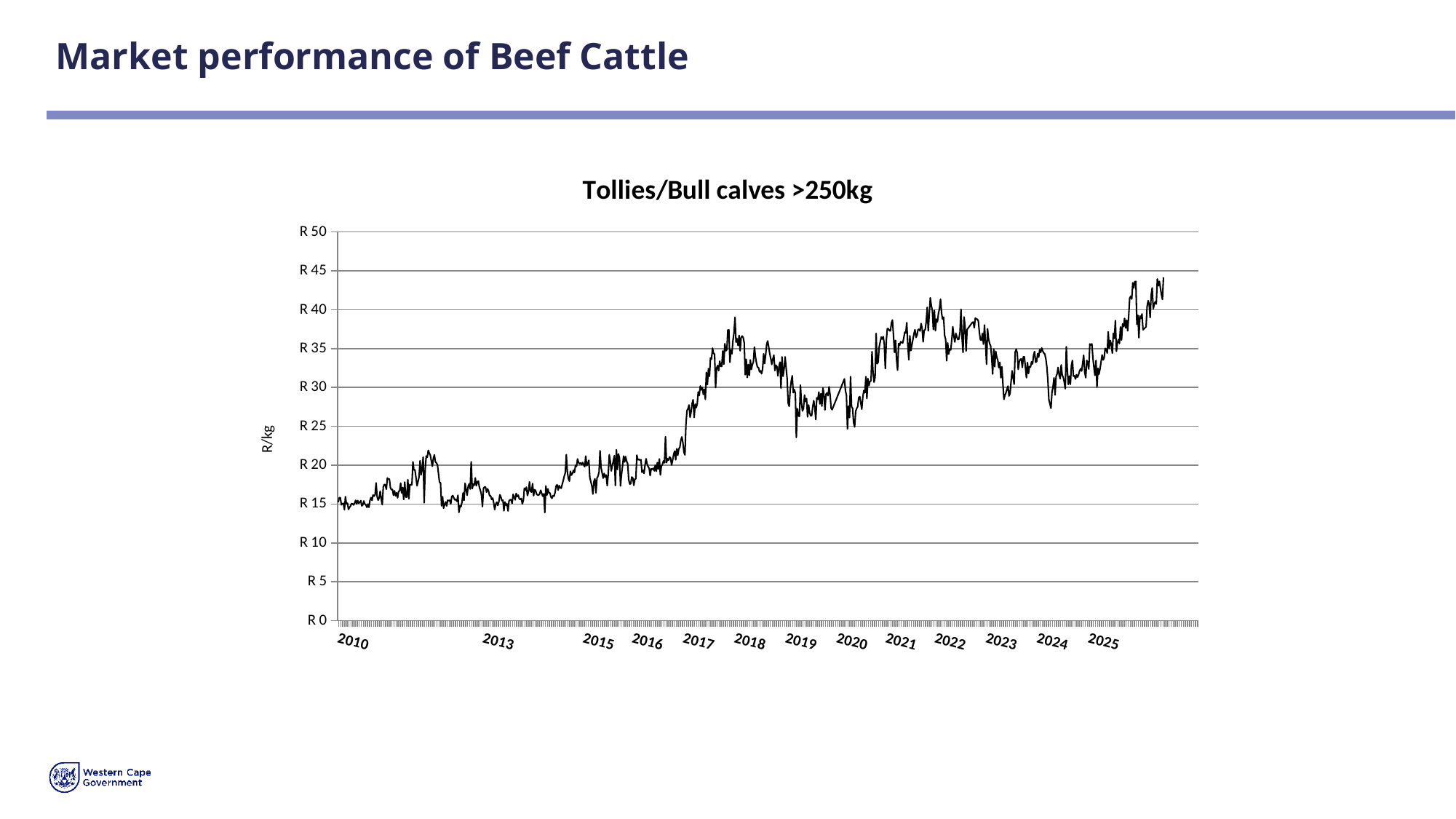
What is the title of the chart? Tollies/Bull calves >250kg Is the value around the start of 2018 greater or less than R 30? greater Is the value around 2013 greater or less than R 25? less Is the value around 2015 greater or less than R 30? less Overall, do the values rise or fall from 2010 to 2025? Rise What is the highest value shown on the vertical axis? R 50 What is the label on the vertical axis of the chart? R/kg What kind of chart is shown on the slide? Line chart Which is larger, the value at the start of 2010 or the value at the end of 2025? The value at the end of 2025